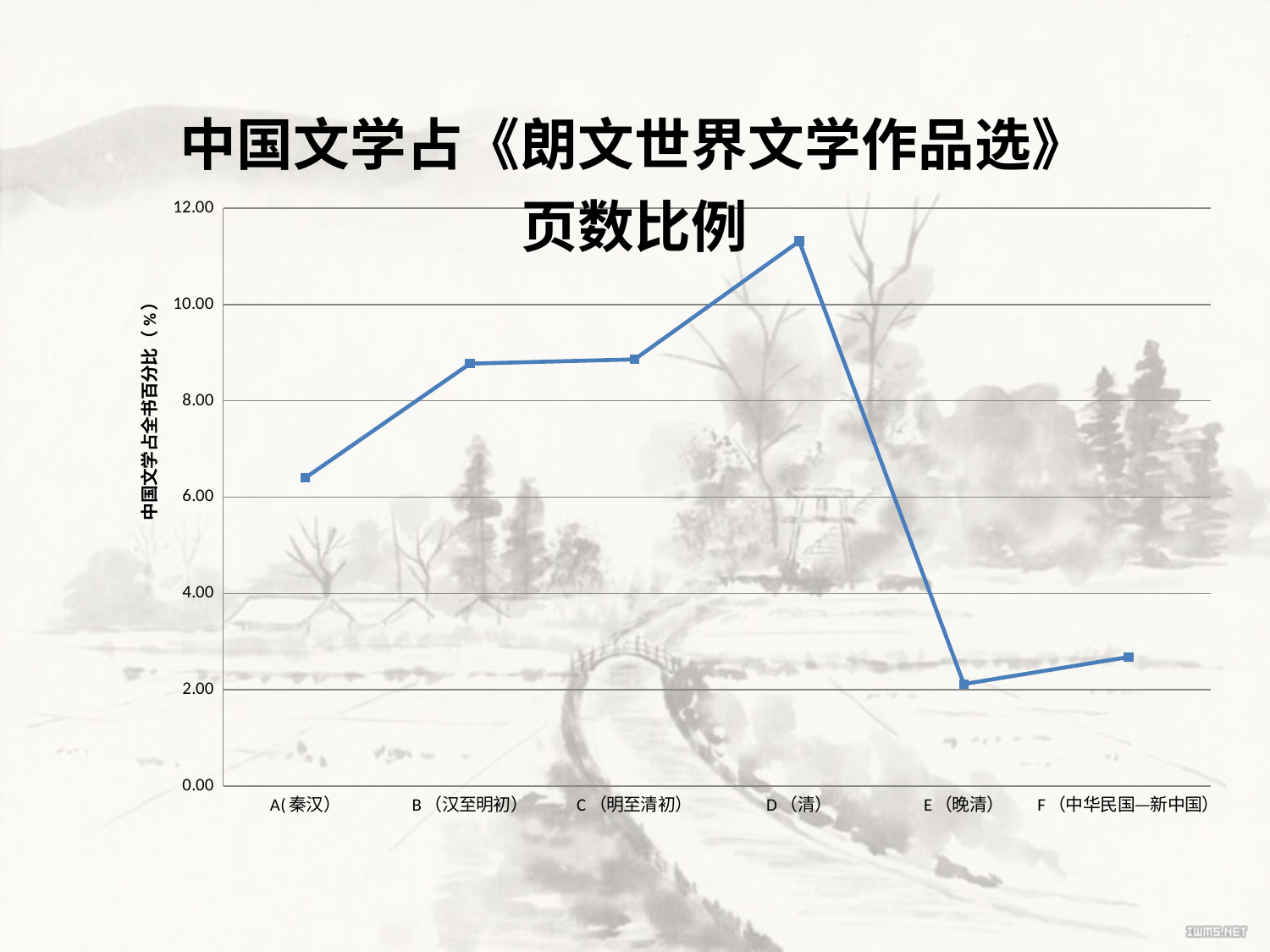
Which has the larger value, C（明至清初） or E（晚清）? C（明至清初） What kind of chart is shown on the slide? line chart Is the value for E（晚清） greater or less than 4.00? less Which has the larger value, A(秦汉) or D（清）? D（清） What is the label of the vertical axis? 中国文学占全书百分比（%） Is the value for A(秦汉) greater or less than 8.00? less Does the line rise or fall from D（清） to E（晚清）? fall Which period has the highest value? D（清） Which period has the lowest value? E（晚清） Is the value for B（汉至明初） greater or less than 8.00? greater How many categories (periods) are plotted along the x axis? 6